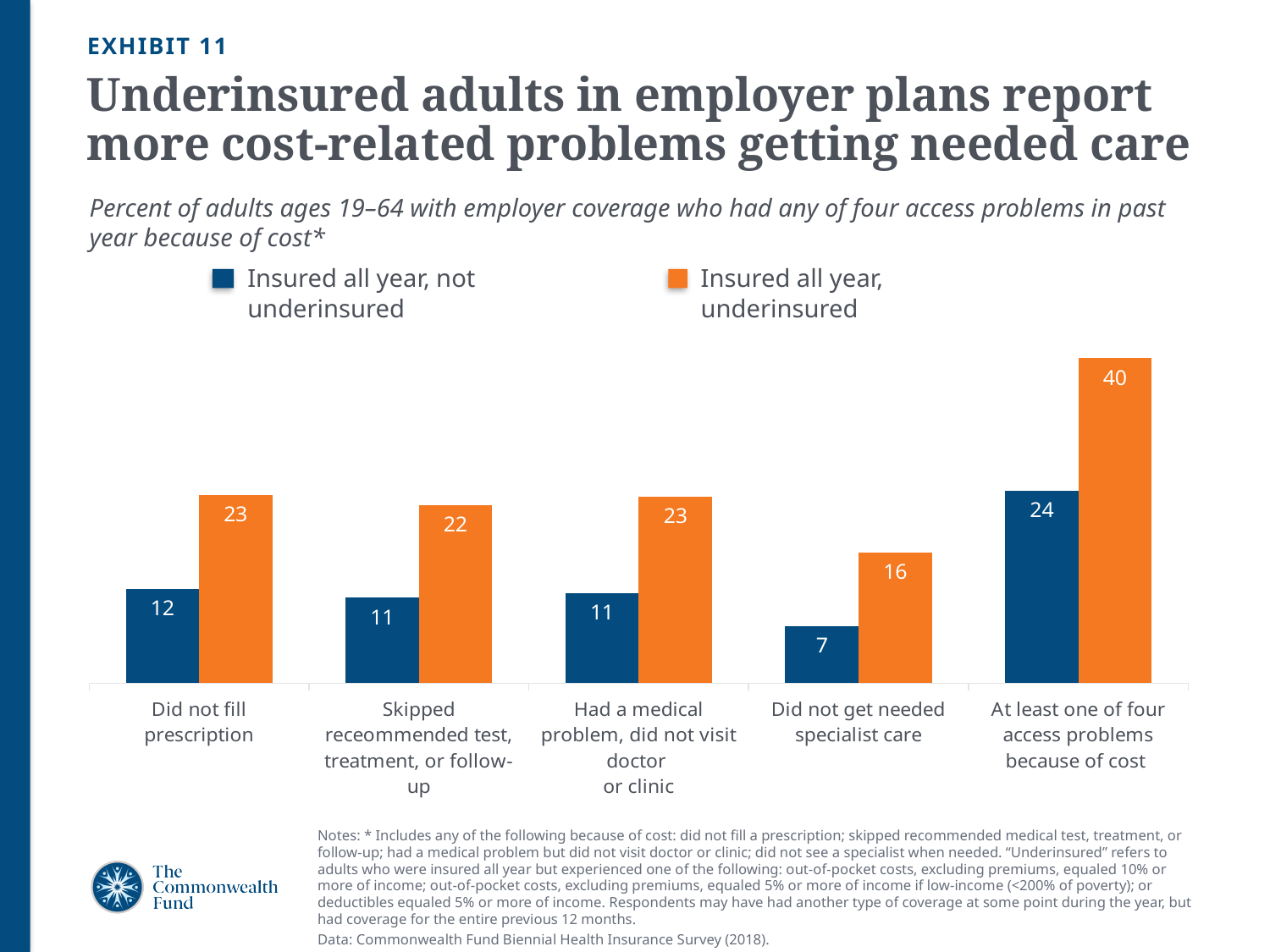
Which category has the lowest value for 'Insured all year, underinsured'? Did not get needed specialist care What is the value for 'Insured all year, underinsured' in the 'Did not fill prescription' category? 23 What is the difference between the two series' values for 'Skipped recommended test, treatment, or follow-up'? 11 What colour represents the 'Insured all year, underinsured' series? Orange Which series has the larger value for 'Had a medical problem, did not visit doctor or clinic'? Insured all year, underinsured What is the value for 'Insured all year, underinsured' in the 'At least one of four access problems because of cost' category? 40 What is the value for 'Insured all year, not underinsured' in the 'Did not get needed specialist care' category? 7 What kind of chart is shown on the slide? Bar chart How many categories are shown on the x axis? 5 Which category has the highest value for 'Insured all year, not underinsured'? At least one of four access problems because of cost What is the difference between the 'Insured all year, underinsured' and 'Insured all year, not underinsured' values for 'At least one of four access problems because of cost'? 16 How many series does the legend list? 2